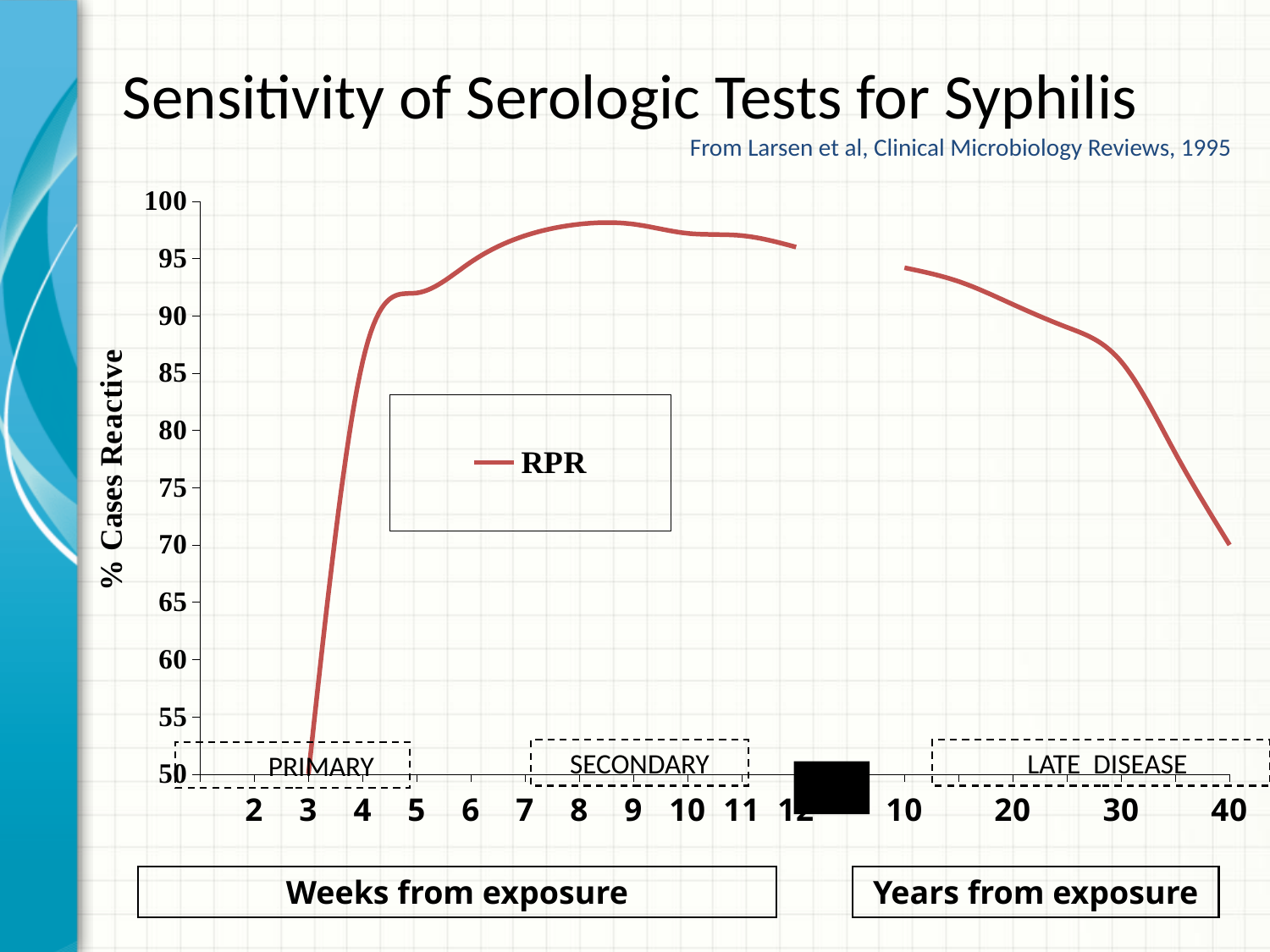
Is the RPR value at 10 weeks from exposure greater or less than 95? greater At which point on the x axis is the RPR line at its lowest? 3 weeks from exposure How many series does the chart legend list? 1 Is the RPR value at 8 weeks from exposure greater or less than 95? greater Does the RPR line rise or fall between 10 years and 40 years from exposure? fall Is the RPR value at 40 years from exposure greater or less than 75? less What kind of chart is shown on the slide? line chart Does the RPR line rise or fall between 3 weeks and 8 weeks from exposure? rise What is the label on the vertical axis of the chart? % Cases Reactive Which is larger, the RPR value at 8 weeks from exposure or at 40 years from exposure? 8 weeks from exposure What series name appears in the chart legend? RPR